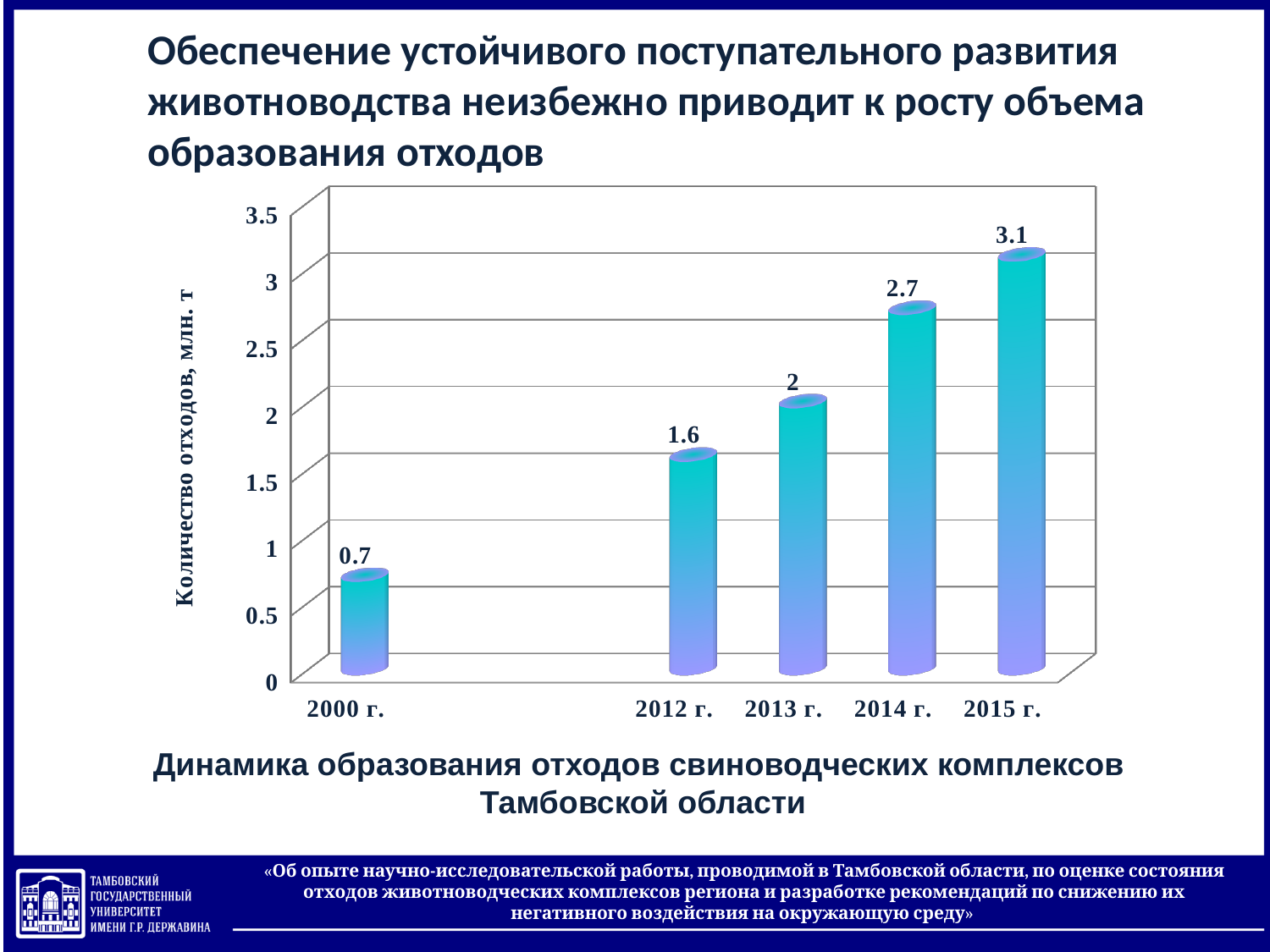
What is the value for 2015 г.? 3.1 What is the difference between the values for 2014 г. and 2012 г.? 1.1 Which year has the highest value? 2015 г. What is the value for 2013 г.? 2 Which is larger, the value for 2012 г. or the value for 2014 г.? 2014 г. Do the values rise or fall from 2000 г. to 2015 г.? rise What is the difference between the values for 2015 г. and 2000 г.? 2.4 What kind of chart is shown? bar chart What is the value for 2000 г.? 0.7 Is the value for 2012 г. greater or less than 1.5? greater Which year has the lowest value? 2000 г. How many years are shown on the x axis? 5